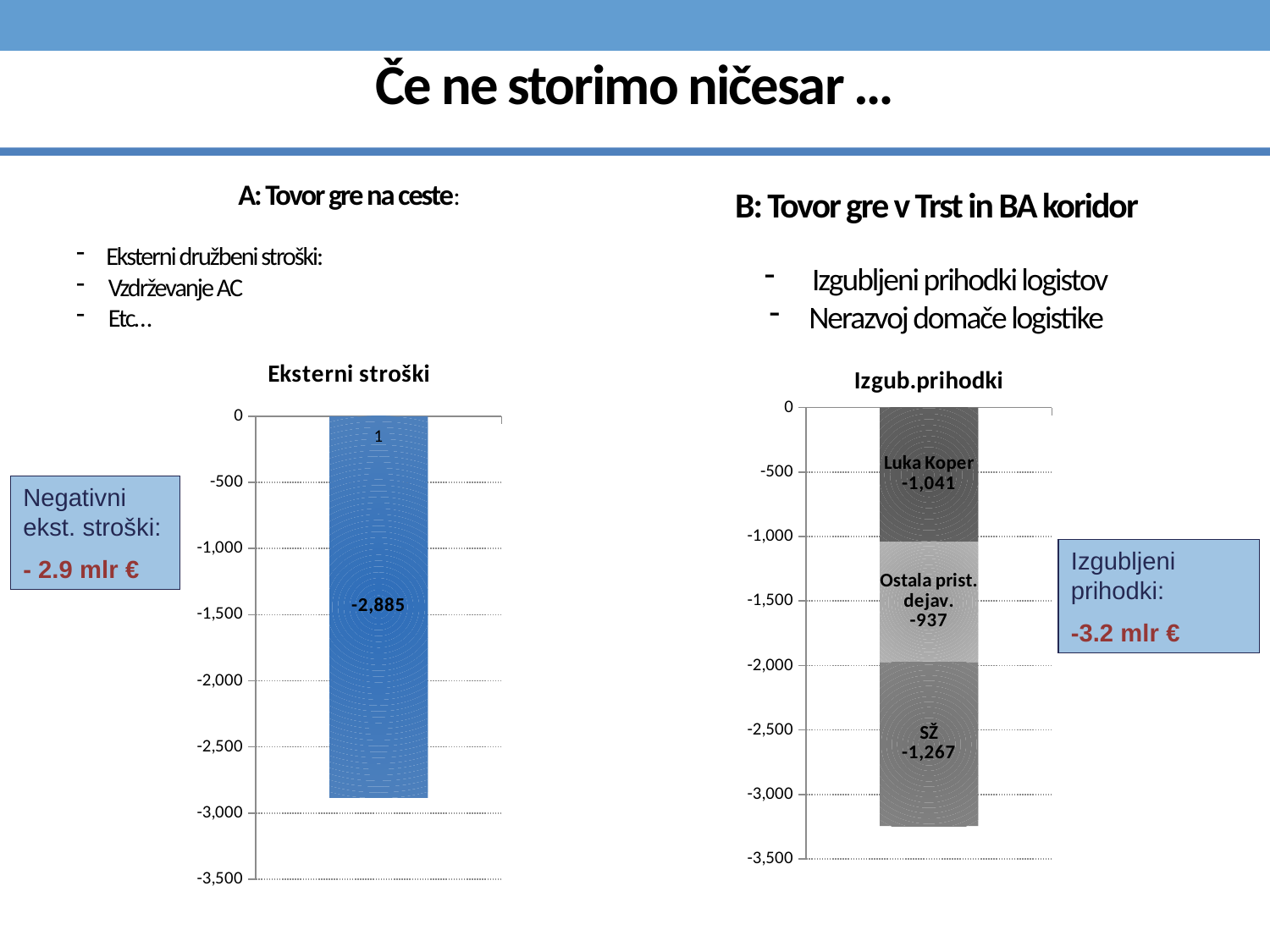
What is the lowest axis tick shown on the 'Eksterni stroški' chart? -3,500 How many segments make up the stacked bar in the 'Izgub.prihodki' chart? 3 What kind of chart is the 'Eksterni stroški' chart? bar chart In the 'Izgub.prihodki' chart, is the magnitude of Luka Koper larger or smaller than that of Ostala prist. dejav.? larger In the 'Izgub.prihodki' chart, what is the value for Luka Koper? -1,041 In the 'Izgub.prihodki' chart, which segment has the smallest magnitude? Ostala prist. dejav. In the 'Izgub.prihodki' chart, which segment has the largest magnitude? SŽ In the 'Izgub.prihodki' chart, what is the value for Ostala prist. dejav.? -937 In the 'Izgub.prihodki' chart, what is the total of the stacked bar? -3,245 In the 'Eksterni stroški' chart, what value is printed on the bar? -2,885 In the 'Izgub.prihodki' chart, what is the difference in magnitude between SŽ and Luka Koper? 226 In the 'Izgub.prihodki' chart, what is the value for SŽ? -1,267